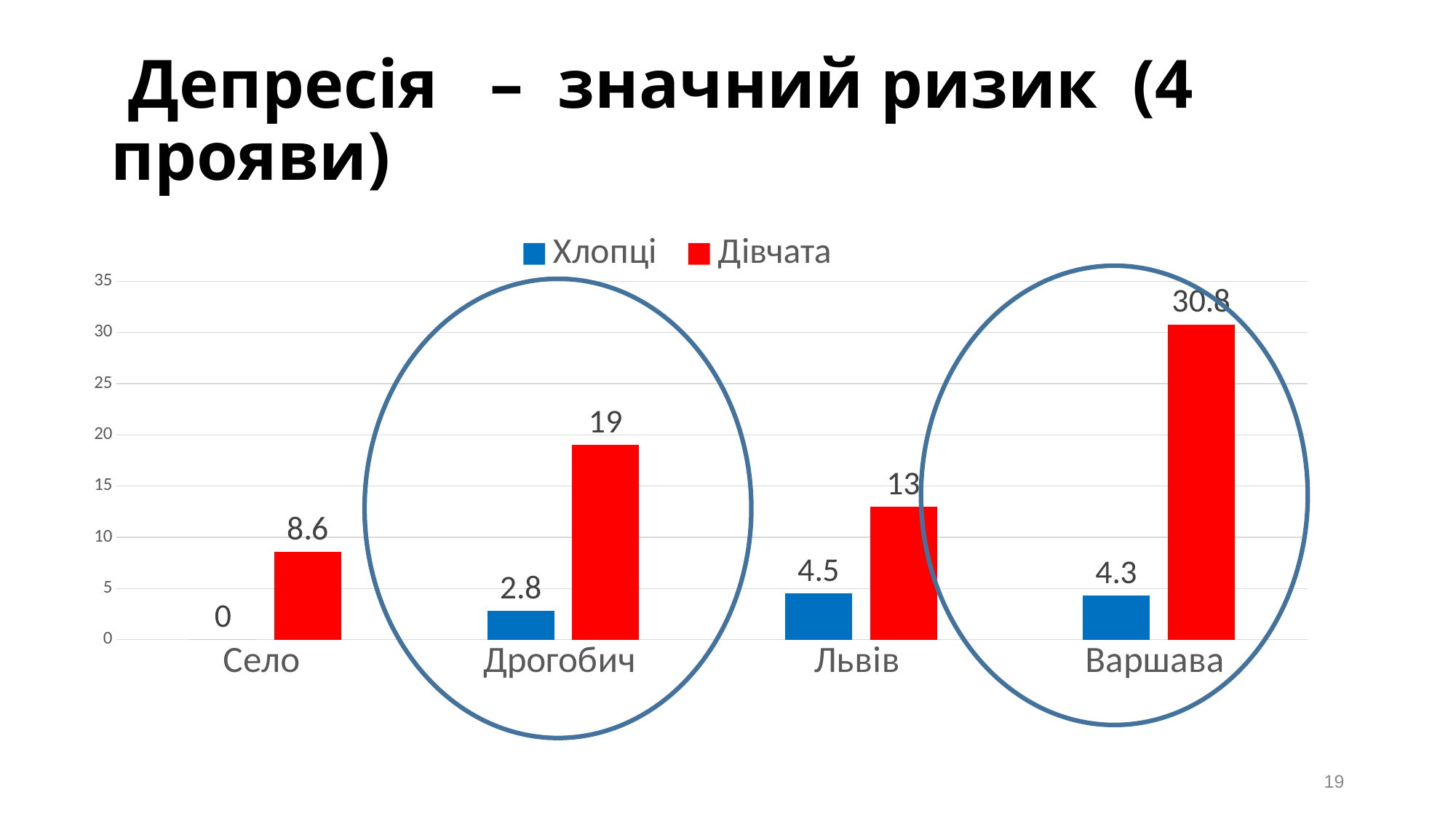
What kind of chart is shown on the slide? Bar chart What is the value for Дівчата in Село? 8.6 What is the value for Хлопці in Дрогобич? 2.8 What is the difference between the Дівчата and Хлопці values in Варшава? 26.5 Which is larger: the Дівчата value for Дрогобич or for Львів? Дрогобич What is the value for Хлопці in Львів? 4.5 What is the value for Дівчата in Варшава? 30.8 What is the difference between the Дівчата values for Дрогобич and Львів? 6 Which category has the lowest value for Хлопці? Село How many categories are shown on the x axis? 4 Which category has the highest value for Дівчата? Варшава How many series does the legend list? 2